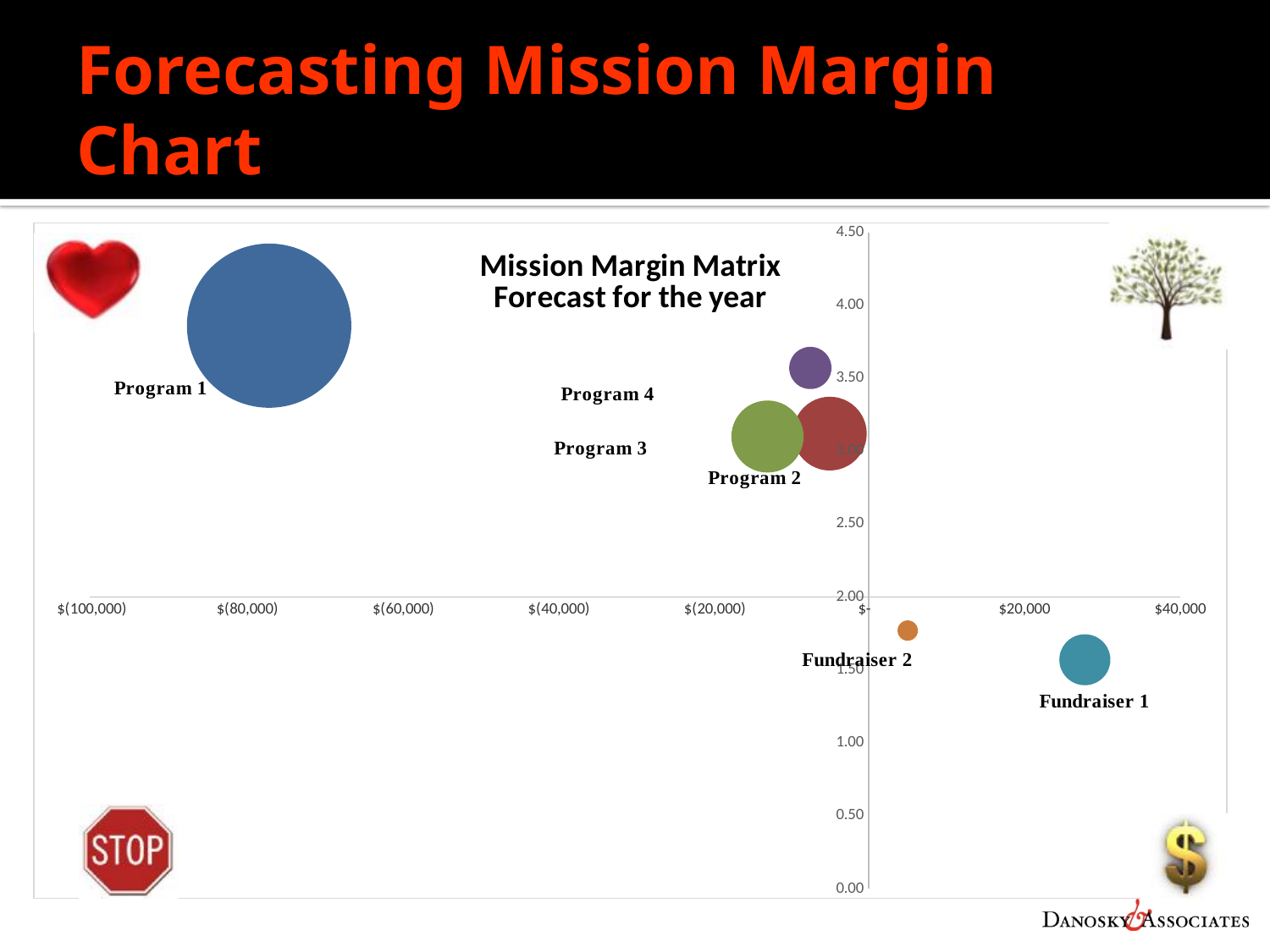
What is the title of the chart? Mission Margin Matrix Forecast for the year Is the vertical value for Program 4 greater or less than 3.00? greater Which bubble is positioned furthest to the left on the horizontal axis? Program 1 Which bubble is positioned furthest to the right on the horizontal axis? Fundraiser 1 Is the vertical value for Fundraiser 1 greater or less than 2.00? less Which has the higher vertical value, Program 1 or Fundraiser 1? Program 1 Is the vertical value for Program 1 greater or less than 3.00? greater What kind of chart is shown on the slide? bubble chart How many labelled bubbles are plotted on the chart? 6 Which bubble is the largest on the chart? Program 1